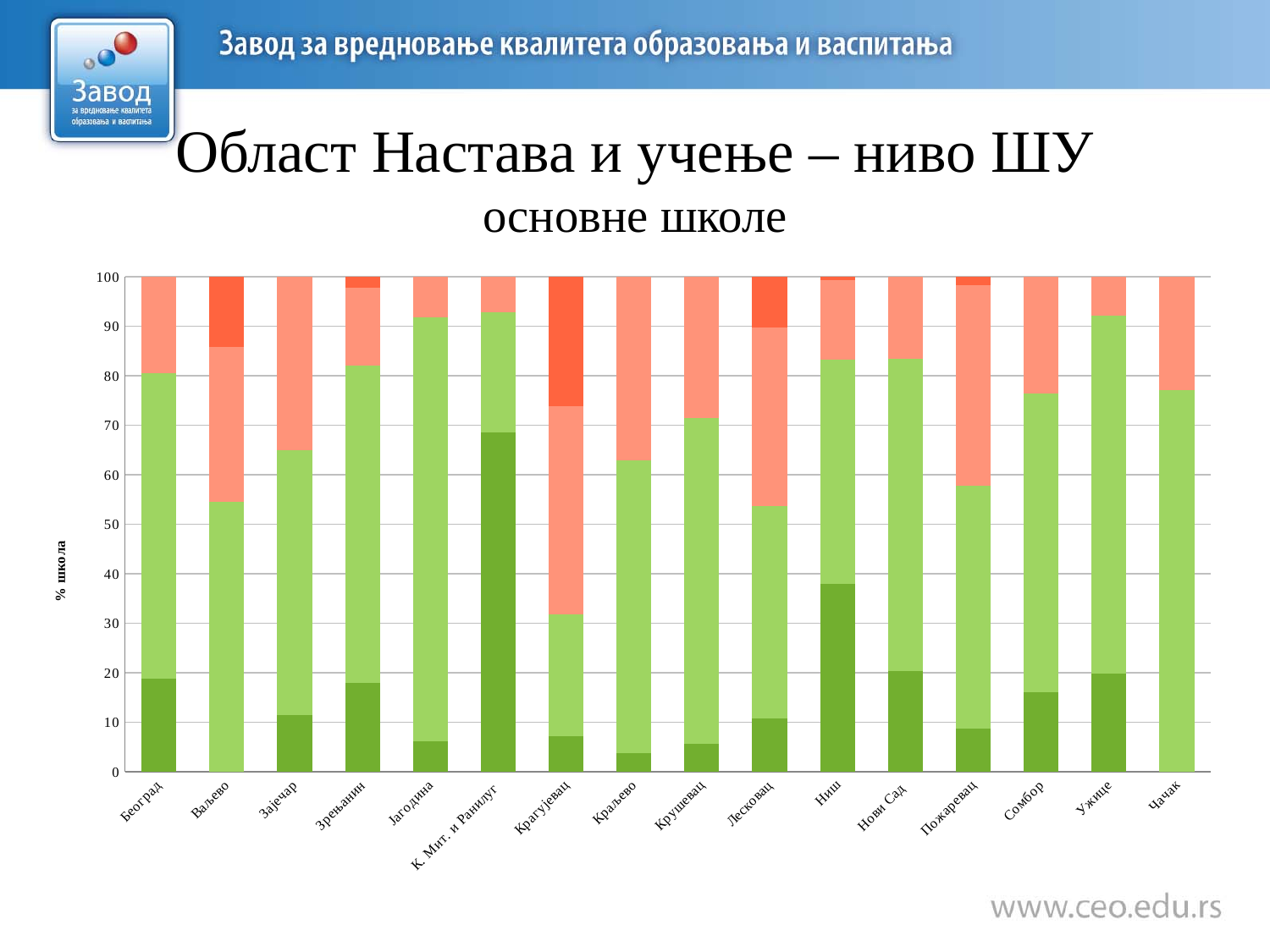
What kind of chart is shown on the slide? stacked bar chart How many categories (cities) are shown along the x axis of the chart? 16 Which category has the tallest dark green (bottom) segment? К. Мит. и Ранилуг Which category has the largest dark red (top) segment? Крагујевац Is the combined green portion of the bar for Јагодина greater or less than 90? greater What is the label of the vertical axis of the chart? % школа What is the total height of each stacked bar in the chart? 100 Is the combined green portion of the bar for Крагујевац greater or less than 40? less Which has the larger dark green (bottom) segment, Ниш or Београд? Ниш Is the dark green (bottom) segment for К. Мит. и Ранилуг greater or less than 60? greater What is the highest value shown on the vertical axis of the chart? 100